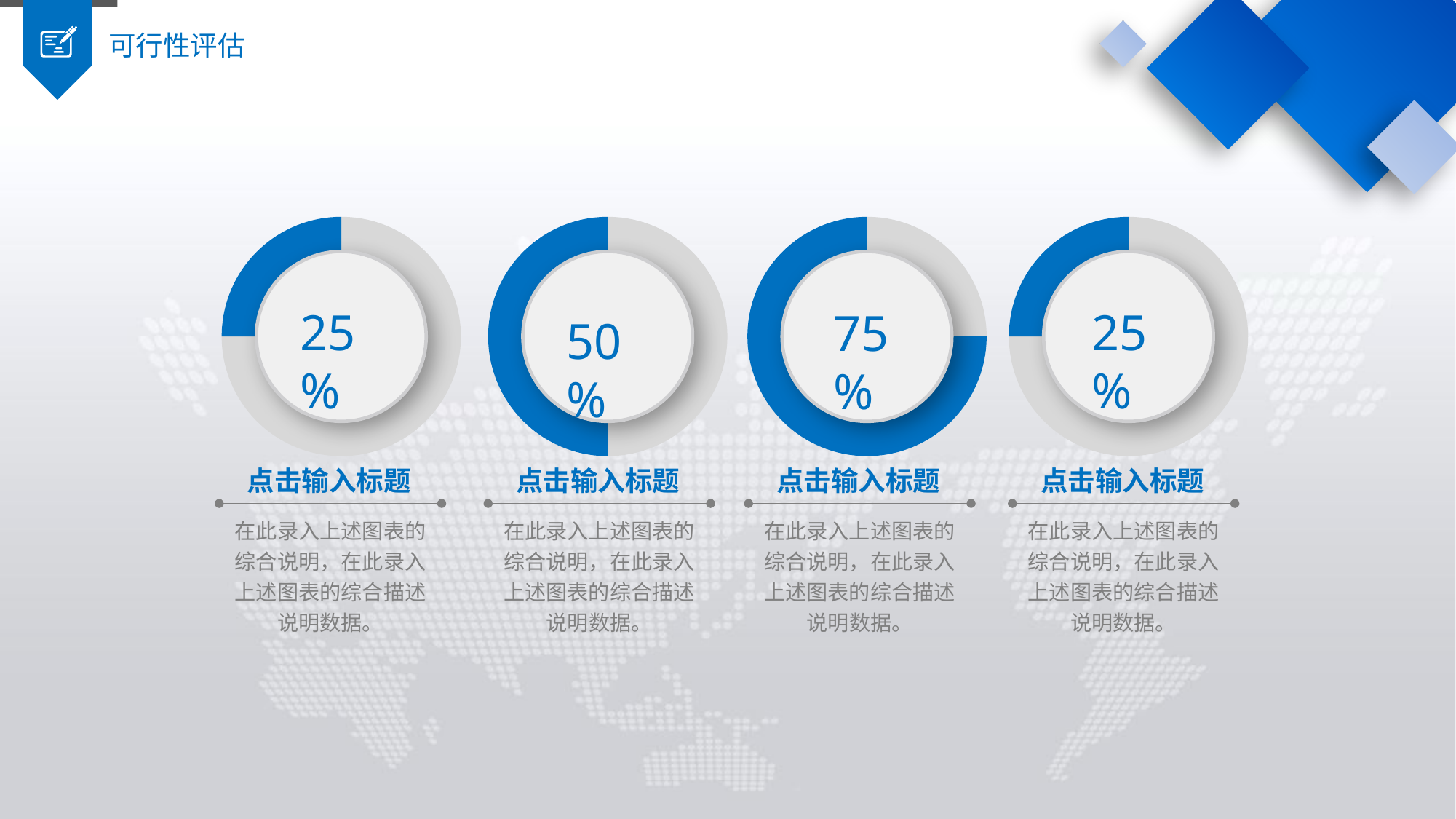
What percentage is shown in the leftmost donut chart? 25% What percentage is shown in the rightmost donut chart? 25% What colour is used for the filled portion of each donut chart? Blue What percentage is shown in the second donut chart from the left? 50% Is the percentage in the third donut chart greater or less than 50%? greater Which donut chart shows the highest percentage? The third from the left (75%) What percentage is shown in the third donut chart from the left? 75% What is the difference between the percentage in the third donut chart and the percentage in the second donut chart? 25% How many donut charts are on the slide? 4 Which is larger, the percentage in the second donut chart or the percentage in the rightmost donut chart? The second donut chart (50%) What kind of chart is used for each of the four figures on the slide? Donut chart What is the difference between the percentage in the third donut chart and the percentage in the leftmost donut chart? 50%